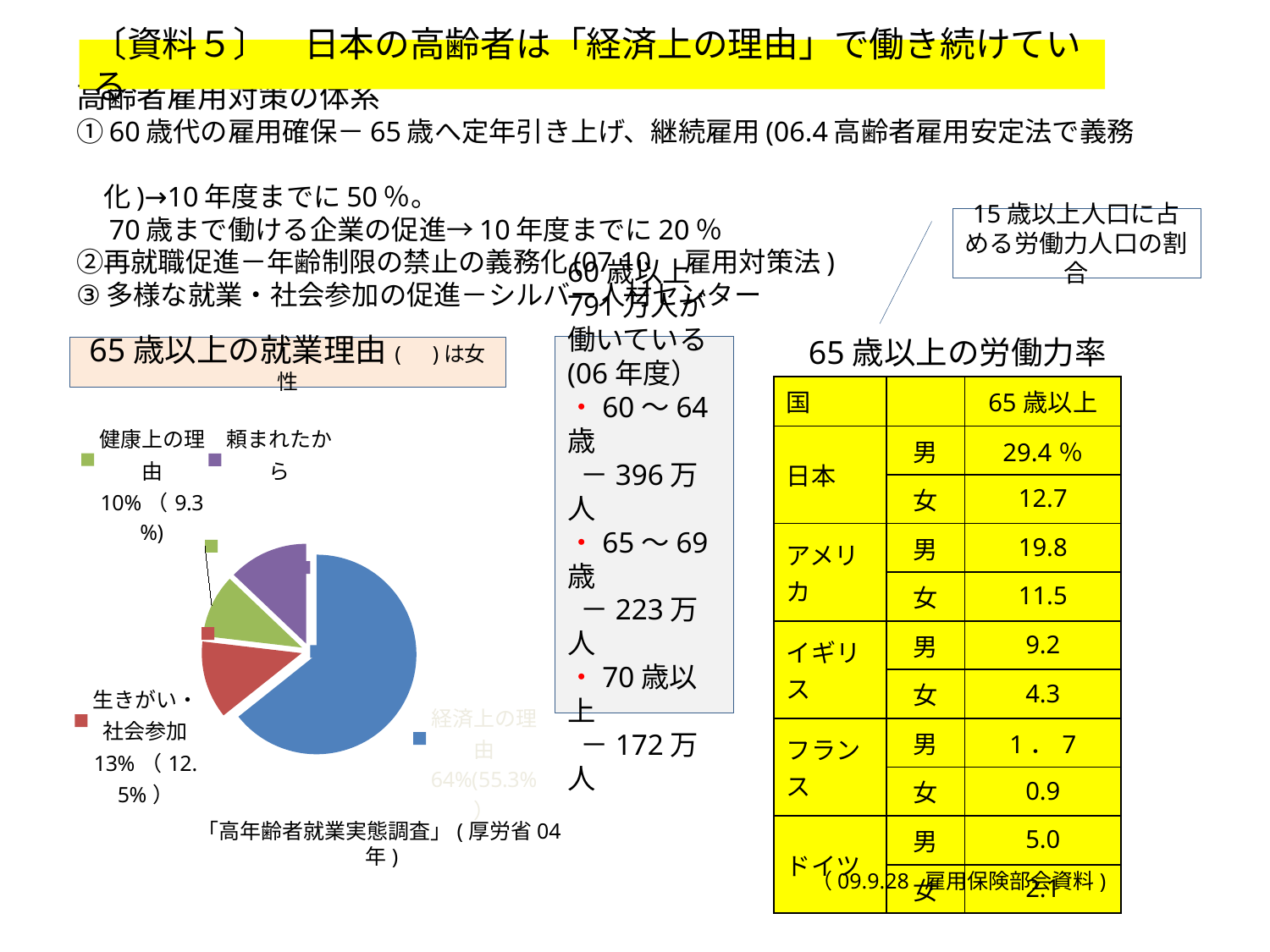
Which category has the largest slice in the 65歳以上の就業理由 pie chart? 経済上の理由 In the 65歳以上の就業理由 pie chart, what share is labelled for 生きがい・社会参加? 13% In the 65歳以上の就業理由 pie chart, what share is labelled for 健康上の理由? 10% How many categories (slices) does the 65歳以上の就業理由 pie chart have? 4 What source is cited below the 65歳以上の就業理由 pie chart? 「高年齢者就業実態調査」(厚労省04年) In the 65歳以上の就業理由 pie chart, how many percentage points larger is 経済上の理由 (64%) than 生きがい・社会参加 (13%)? 51 percentage points In the 65歳以上の就業理由 pie chart, what share is labelled for 経済上の理由? 64% What kind of chart is used to show 65歳以上の就業理由? Pie chart In the 65歳以上の就業理由 pie chart, what is the value in parentheses (women) for 生きがい・社会参加? 12.5% In the 65歳以上の就業理由 pie chart, what is the value in parentheses (women) for 経済上の理由? 55.3% In the 65歳以上の就業理由 pie chart, which is larger: 経済上の理由 or 生きがい・社会参加? 経済上の理由 In the 65歳以上の就業理由 pie chart, what is the value in parentheses (women) for 健康上の理由? 9.3%